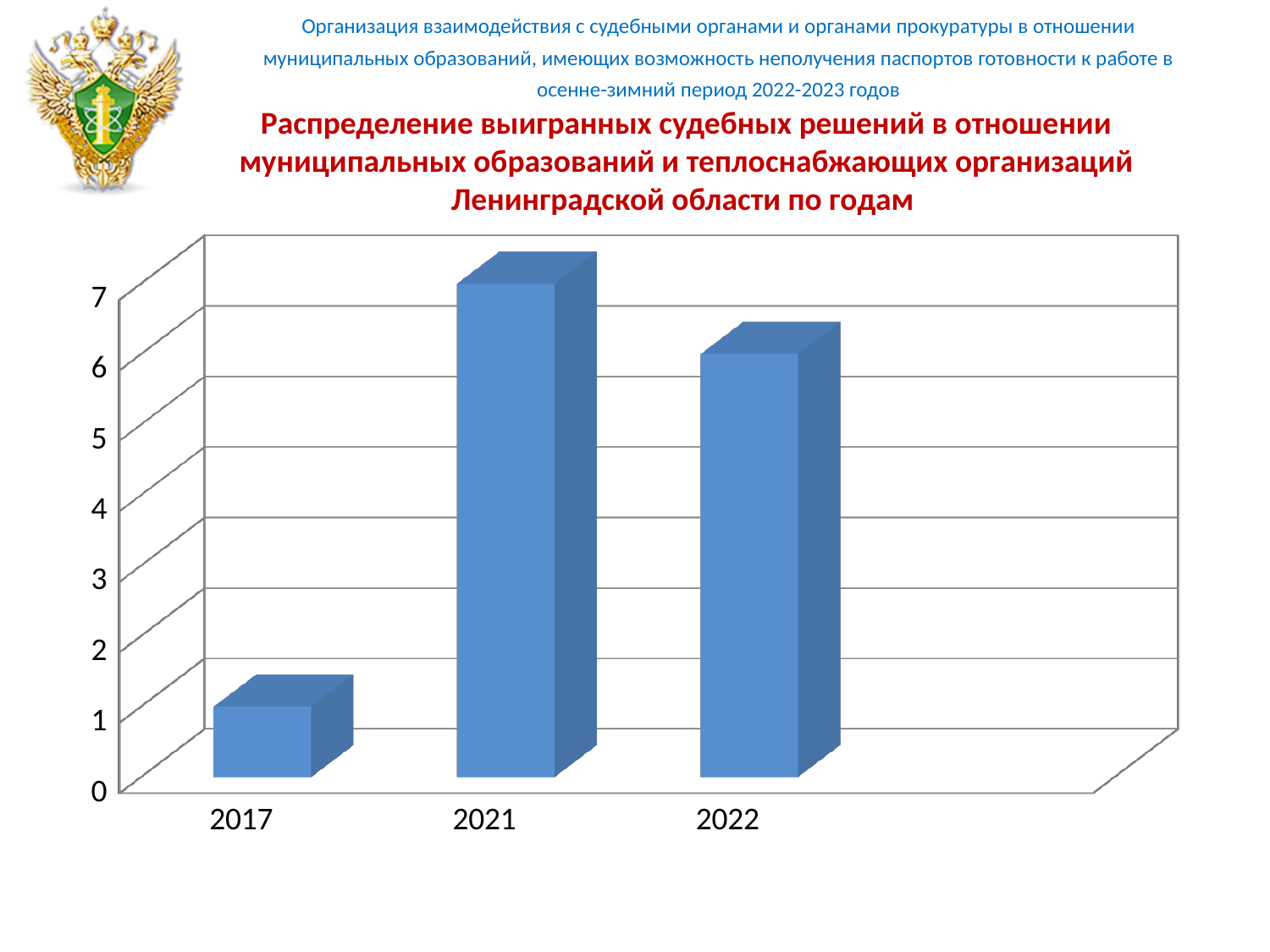
Is the value for 2017 greater or less than 2? less Which year has the lowest bar in the chart? 2017 What is the highest value labelled on the vertical axis of the chart? 7 Does the value rise or fall from 2021 to 2022? fall Which year has the larger value, 2017 or 2022? 2022 Does the value rise or fall from 2017 to 2021? rise Which year has the larger value, 2021 or 2022? 2021 How many years (categories) are shown on the x axis of the chart? 3 What kind of chart is shown on the slide? bar chart Which year has the highest bar in the chart? 2021 Is the value for 2022 greater or less than 4? greater Is the value for 2021 greater or less than 5? greater